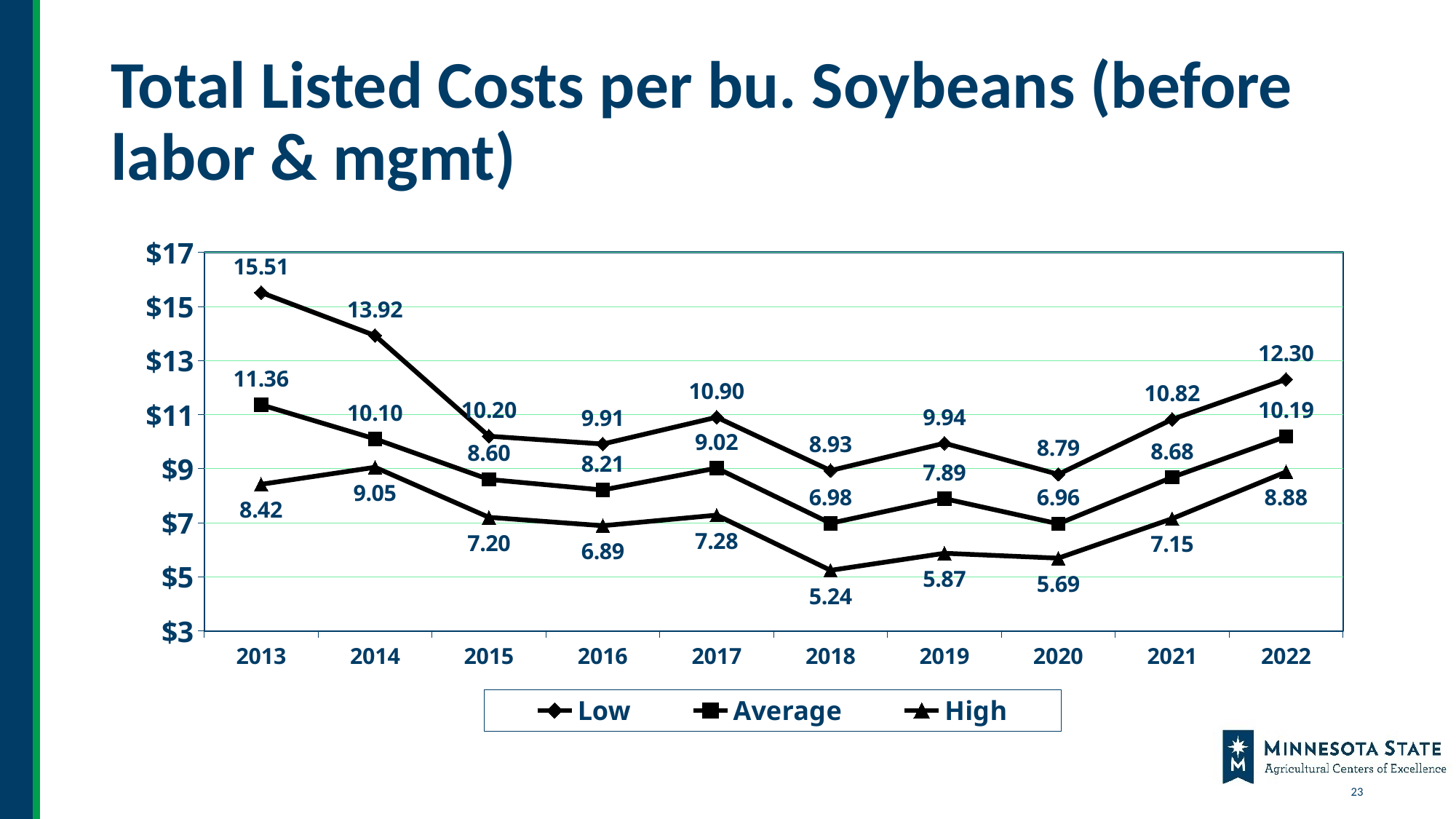
Which marker shape does the legend use for the High series? triangle Does the Average series rise or fall from 2020 to 2022? rise What is the Low series value for 2013? 15.51 What is the High series value for 2018? 5.24 In which year is the High series at its lowest value? 2018 What is the Average series value for 2022? 10.19 How many series does the legend list? 3 In which year is the Low series at its highest value? 2013 What kind of chart is shown on the slide? line chart How many years are shown on the x axis? 10 Which is larger, the Average value in 2017 or the Average value in 2019? 2017 What is the difference between the Low and High series values in 2013? 7.09